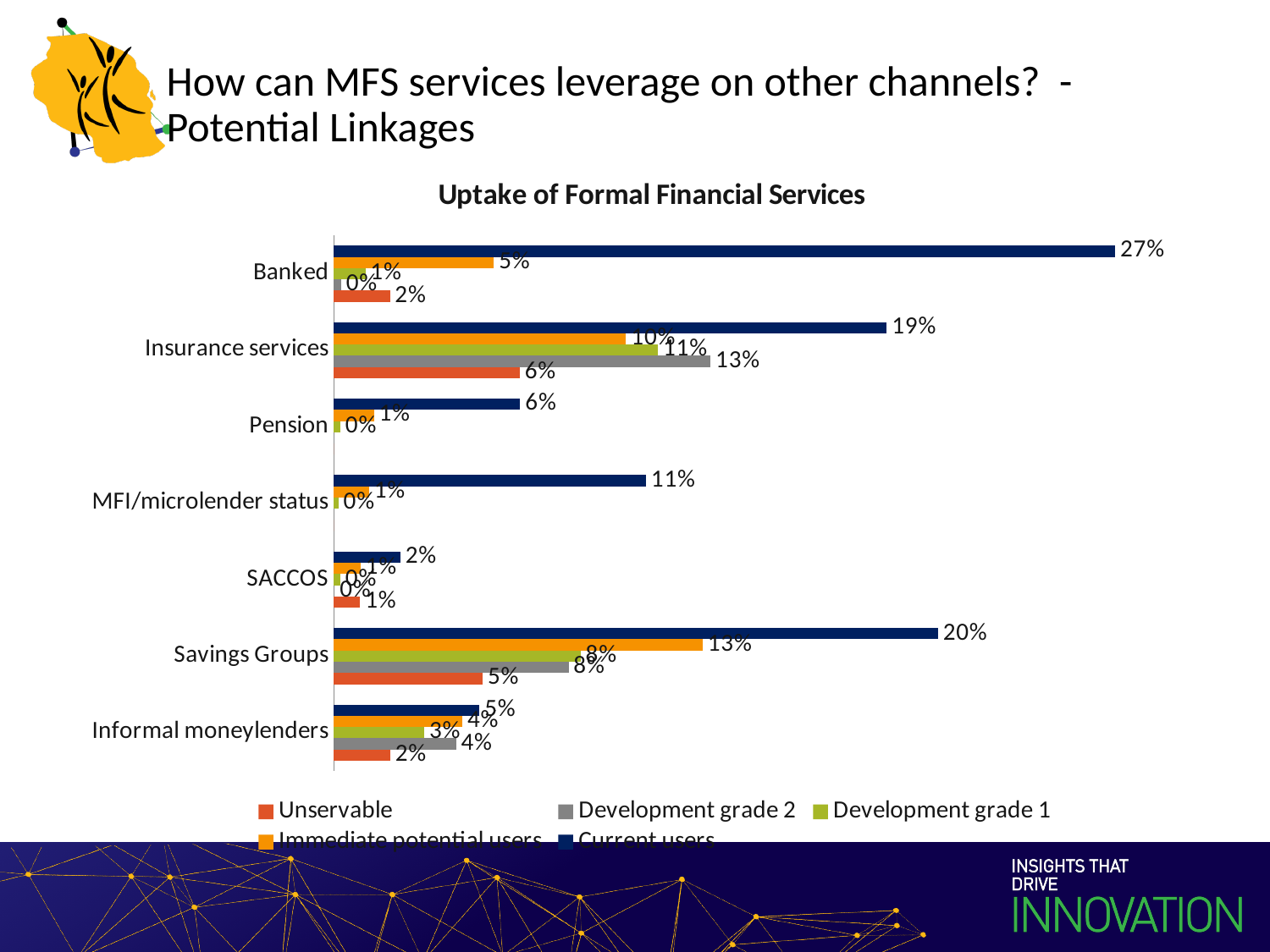
What is the Current users value for Banked? 27% What kind of chart is shown on the slide? Bar chart Which category has the lowest Current users value? SACCOS Which has the larger Current users value, Savings Groups or Insurance services? Savings Groups How many categories are shown on the chart? 7 What is the Immediate potential users value for Savings Groups? 13% What is the Development grade 2 value for Insurance services? 13% What is the difference between the Current users values for Banked and Insurance services? 8% How many series does the legend list? 5 What is the title of the chart? Uptake of Formal Financial Services What is the Unservable value for Insurance services? 6% Which category has the highest Current users value? Banked